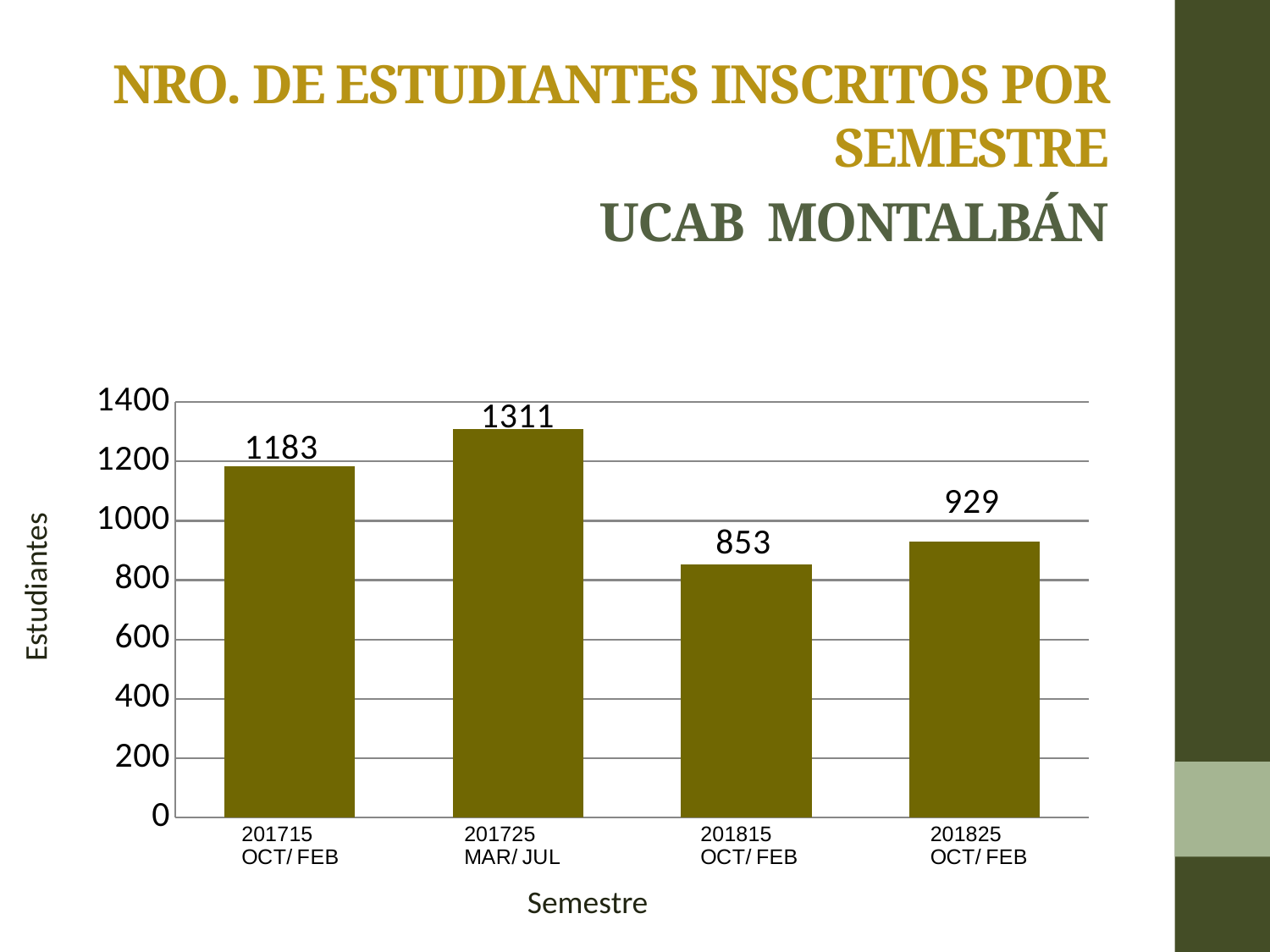
What is the number of students enrolled in semester 201725 MAR/JUL? 1311 What is the difference in enrolled students between semester 201725 MAR/JUL and semester 201815 OCT/FEB? 458 What kind of chart is shown on the slide? Bar chart What is the number of students enrolled in semester 201825 OCT/FEB? 929 Which semester has more enrolled students, 201715 OCT/FEB or 201825 OCT/FEB? 201715 OCT/FEB Which semester has the highest number of enrolled students? 201725 MAR/JUL What is the number of students enrolled in semester 201715 OCT/FEB? 1183 How many semesters are shown on the chart? 4 What is the number of students enrolled in semester 201815 OCT/FEB? 853 What is the label of the vertical axis of the chart? Estudiantes Is the value for semester 201825 OCT/FEB greater or less than 1000? less Which semester has the lowest number of enrolled students? 201815 OCT/FEB